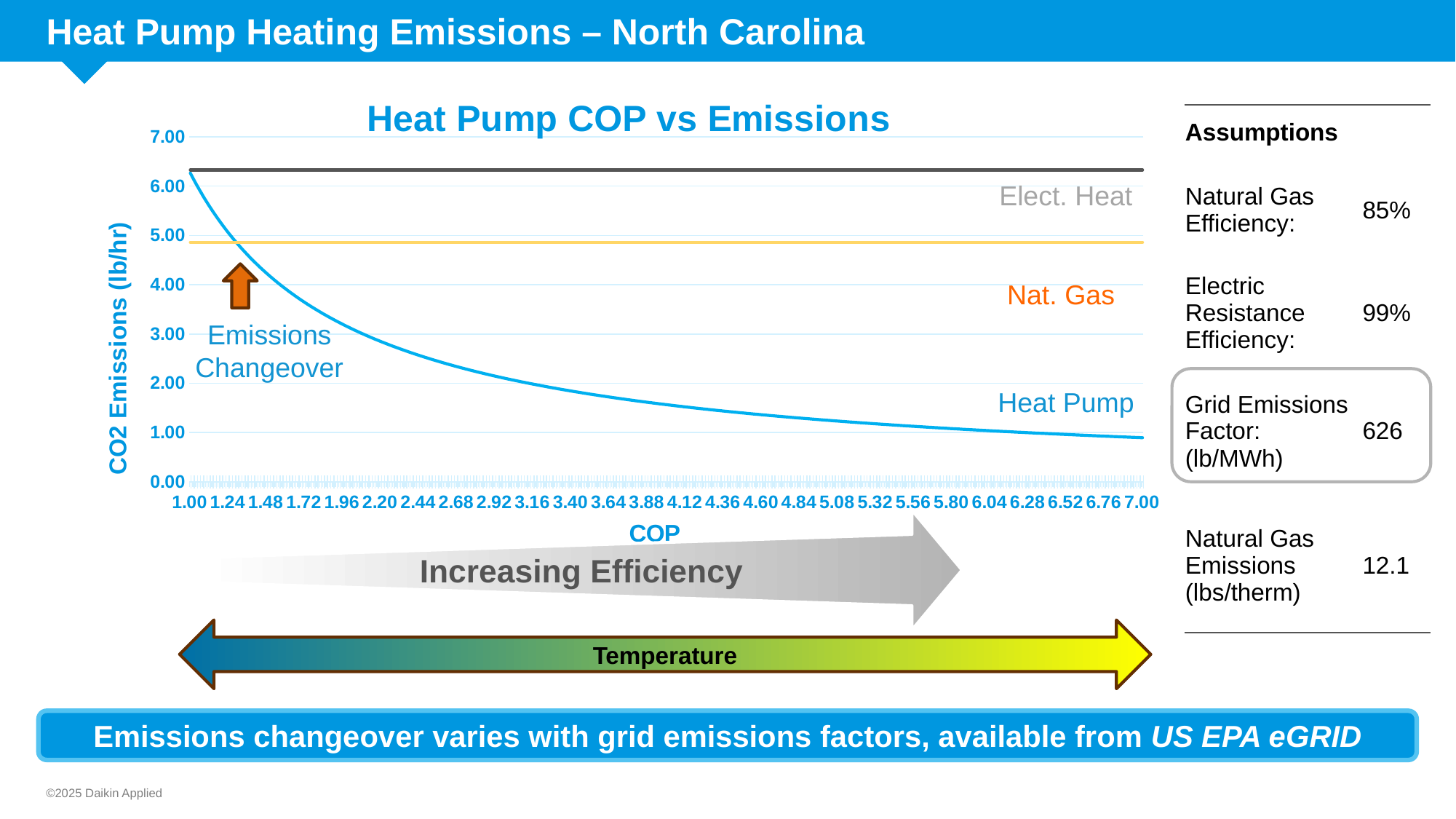
How many series are plotted in the 'Heat Pump COP vs Emissions' chart? 3 In the 'Heat Pump COP vs Emissions' chart, is the Heat Pump value at a COP of 4.12 greater or less than 2.00? less In the 'Heat Pump COP vs Emissions' chart, which has higher emissions at a COP of 3.16, Heat Pump or Nat. Gas? Nat. Gas In the 'Heat Pump COP vs Emissions' chart, which series has the highest emissions at a COP of 7.00? Elect. Heat In the 'Heat Pump COP vs Emissions' chart, which series has the lowest emissions at a COP of 7.00? Heat Pump What kind of chart is 'Heat Pump COP vs Emissions'? line chart In the 'Heat Pump COP vs Emissions' chart, is the Heat Pump value at a COP of 1.00 greater or less than 6.00? greater In the 'Heat Pump COP vs Emissions' chart, is the Elect. Heat value greater or less than 6.00? greater In the 'Heat Pump COP vs Emissions' chart, do the Heat Pump emissions rise or fall as COP increases? fall What is the y-axis label of the 'Heat Pump COP vs Emissions' chart? CO2 Emissions (lb/hr) In the 'Heat Pump COP vs Emissions' chart, which has higher emissions, Elect. Heat or Nat. Gas? Elect. Heat